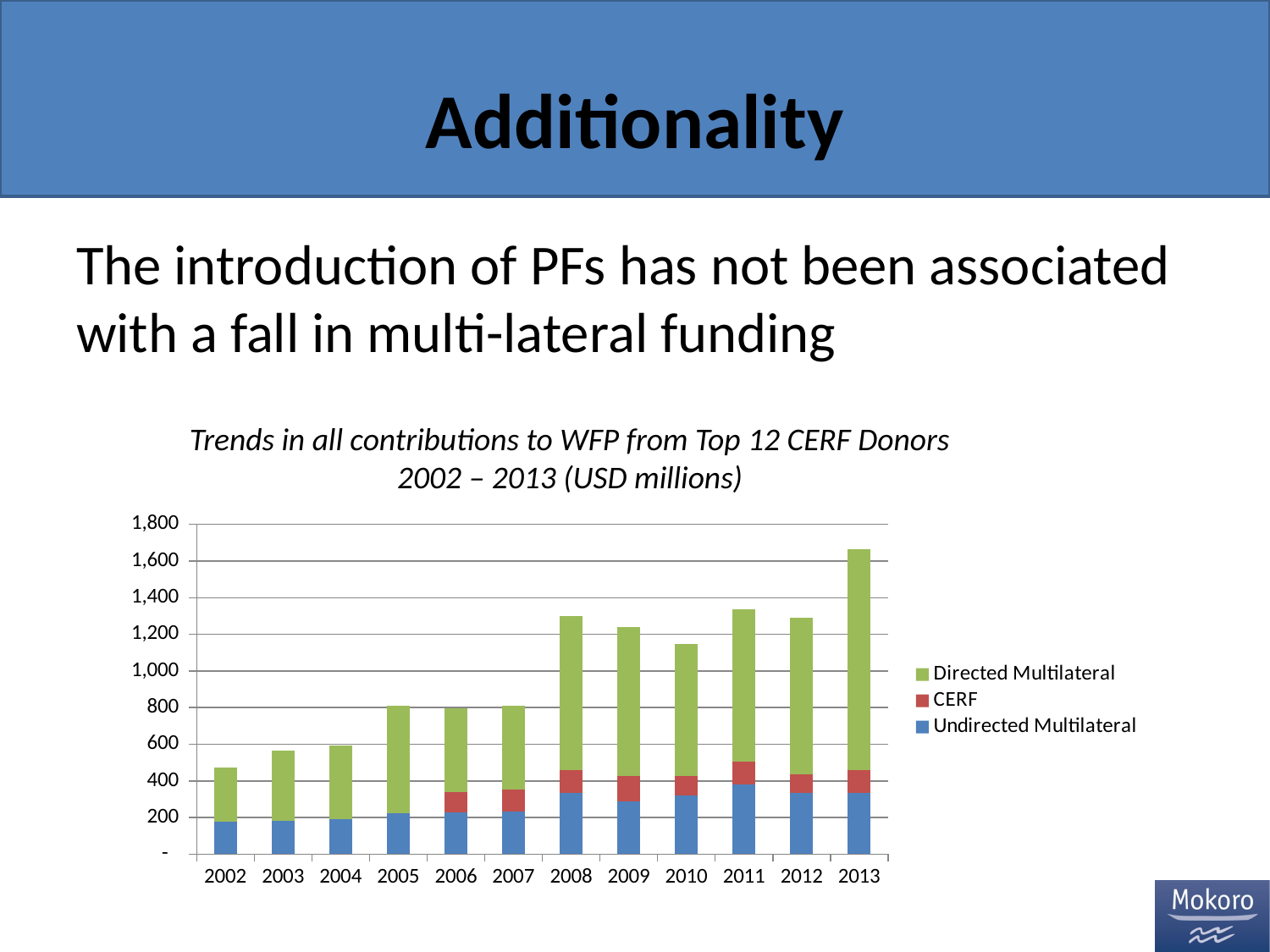
Which year has the highest total contributions in the chart? 2013 How many series does the chart's legend list? 3 What kind of chart is shown on the slide? Stacked bar chart Which series is shown in green in the chart's legend? Directed Multilateral Do total contributions generally rise or fall from 2002 to 2013? rise Which year has a larger total, 2009 or 2010? 2009 Which year has the lowest total contributions in the chart? 2002 Is the total value for 2011 greater or less than 1,200? greater Is the total value for 2010 greater or less than 1,200? less Is the total value for 2002 greater or less than 600? less How many years are shown on the x axis of the chart? 12